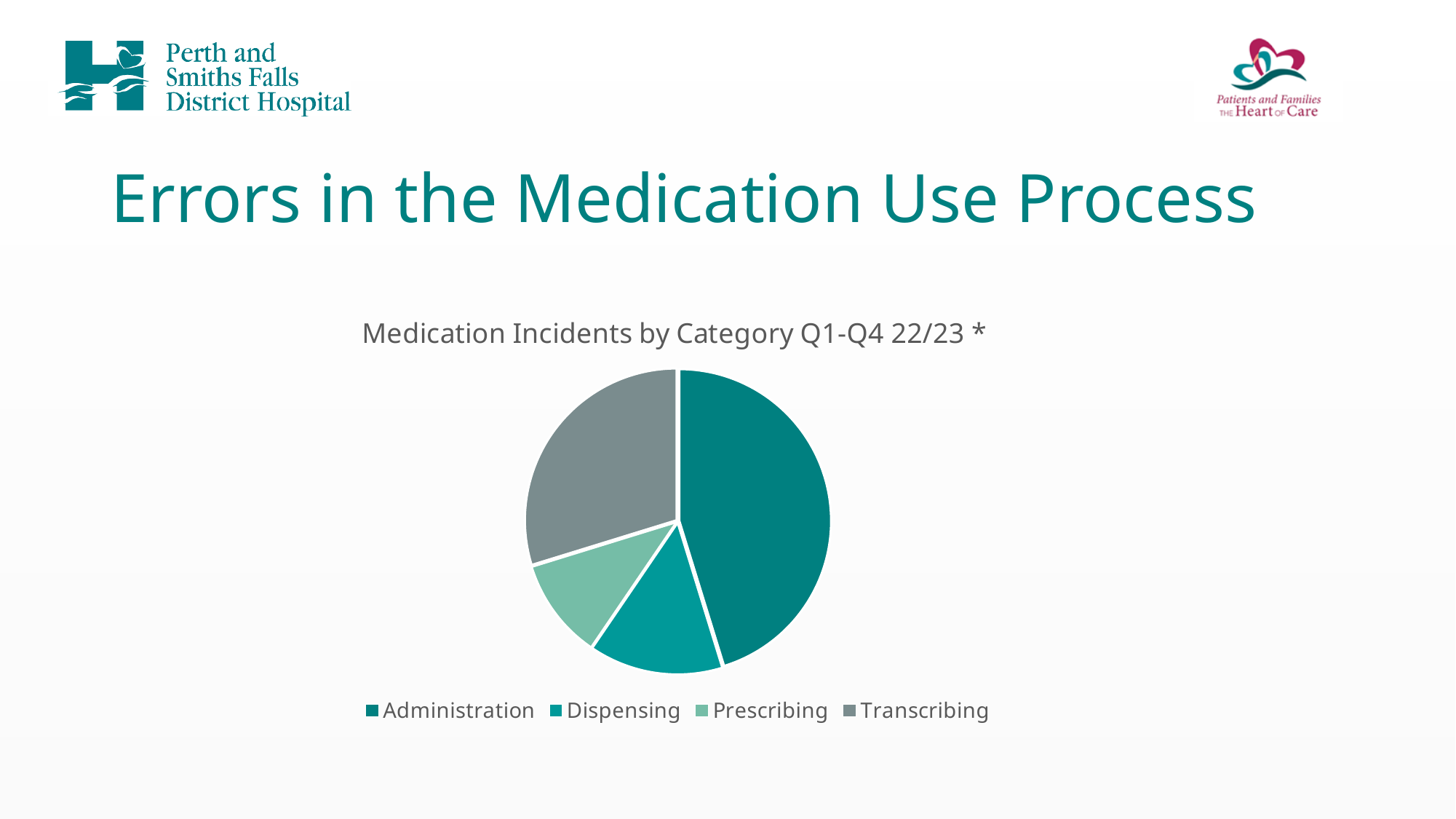
What is the title of the pie chart? Medication Incidents by Category Q1-Q4 22/23 * What kind of chart is shown on the slide? Pie chart Which categories are listed in the chart legend? Administration, Dispensing, Prescribing, Transcribing Which slice is larger, Transcribing or Prescribing? Transcribing Which slice is larger, Administration or Transcribing? Administration Which slice is larger, Prescribing or Administration? Administration How many categories does the pie chart show? 4 Which category has the largest slice of the pie chart? Administration